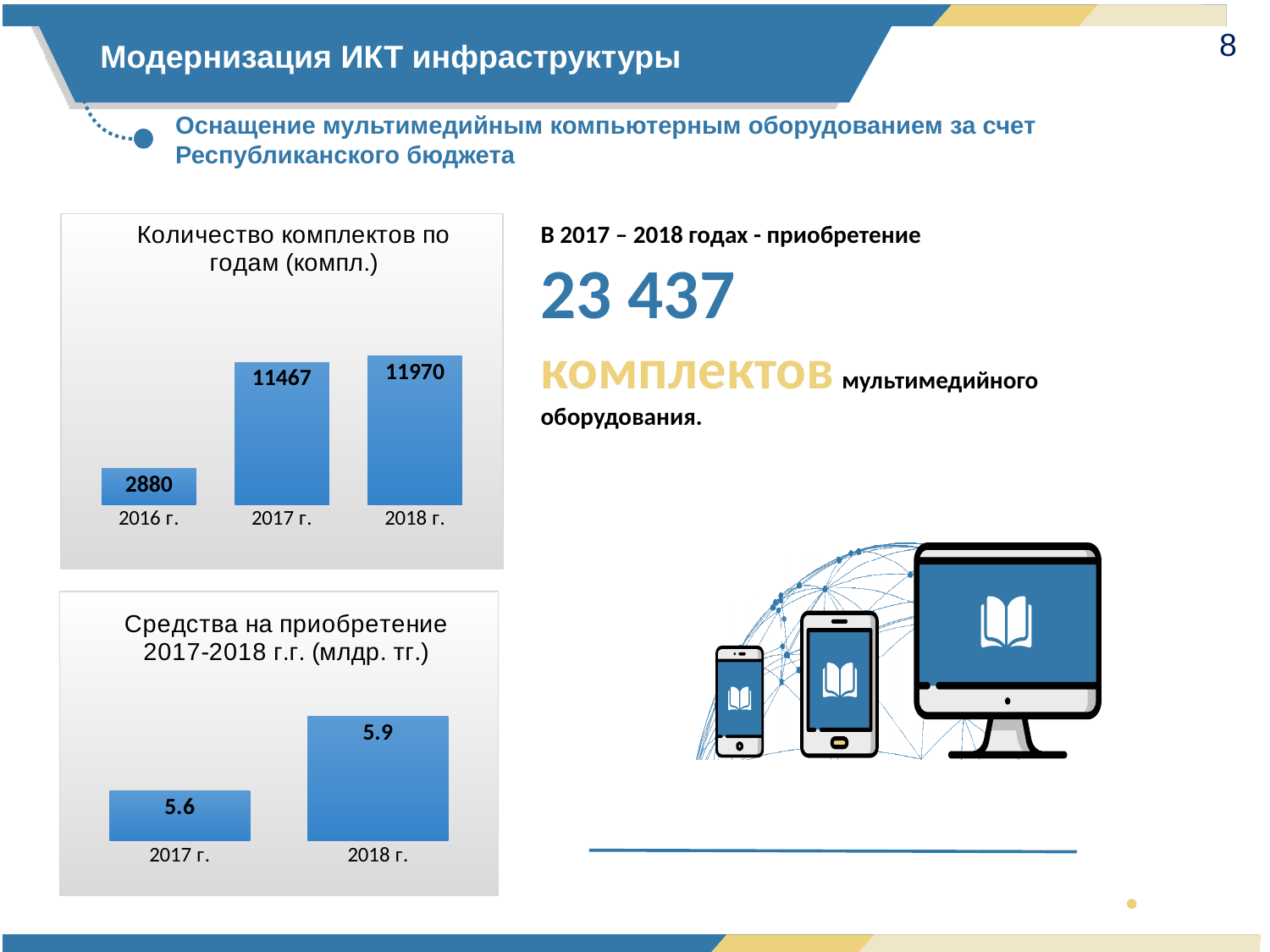
In the chart 'Количество комплектов по годам (компл.)', what is the value for 2017 г.? 11467 In the chart 'Средства на приобретение 2017-2018 г.г. (млдр. тг.)', what is the difference between the values for 2018 г. and 2017 г.? 0.3 In the chart 'Количество комплектов по годам (компл.)', how many years are shown? 3 In the chart 'Средства на приобретение 2017-2018 г.г. (млдр. тг.)', what is the value for 2017 г.? 5.6 In the chart 'Количество комплектов по годам (компл.)', which year has the lowest value? 2016 г. In the chart 'Средства на приобретение 2017-2018 г.г. (млдр. тг.)', what is the value for 2018 г.? 5.9 In the chart 'Количество комплектов по годам (компл.)', which year has the highest value? 2018 г. In the chart 'Количество комплектов по годам (компл.)', do the values rise or fall from 2016 г. to 2018 г.? rise In the chart 'Количество комплектов по годам (компл.)', what is the difference between the values for 2018 г. and 2017 г.? 503 What type of chart is the bottom-left chart on the slide? bar chart In the chart 'Средства на приобретение 2017-2018 г.г. (млдр. тг.)', which year has the larger value, 2017 г. or 2018 г.? 2018 г. In the chart 'Количество комплектов по годам (компл.)', what is the value for 2016 г.? 2880